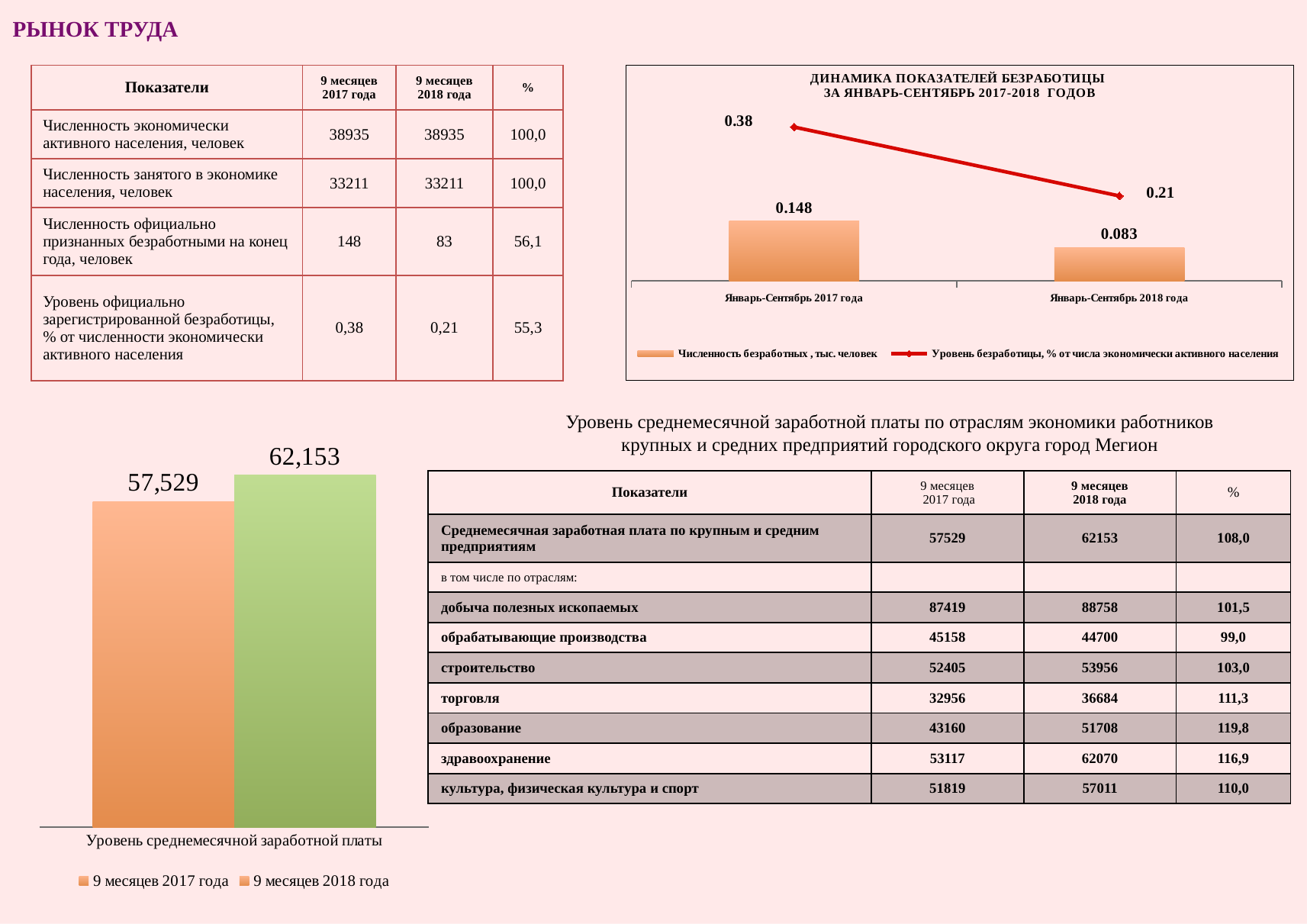
In the bottom-left chart 'Уровень среднемесячной заработной платы', what is the value for 9 месяцев 2017 года? 57,529 In the chart titled 'ДИНАМИКА ПОКАЗАТЕЛЕЙ БЕЗРАБОТИЦЫ', which period has the higher 'Численность безработных' bar? Январь-Сентябрь 2017 года In the bottom-left chart 'Уровень среднемесячной заработной платы', what is the value for 9 месяцев 2018 года? 62,153 What kind of chart is the bottom-left chart 'Уровень среднемесячной заработной платы'? bar chart In the chart titled 'ДИНАМИКА ПОКАЗАТЕЛЕЙ БЕЗРАБОТИЦЫ', what is the 'Уровень безработицы' value for Январь-Сентябрь 2018 года? 0.21 In the bottom-left chart 'Уровень среднемесячной заработной платы', what is the difference between the 2018 and 2017 values? 4,624 In the chart titled 'ДИНАМИКА ПОКАЗАТЕЛЕЙ БЕЗРАБОТИЦЫ', what is the 'Уровень безработицы' value for Январь-Сентябрь 2017 года? 0.38 In the chart titled 'ДИНАМИКА ПОКАЗАТЕЛЕЙ БЕЗРАБОТИЦЫ', does the unemployment rate line rise or fall from 2017 to 2018? fall In the chart titled 'ДИНАМИКА ПОКАЗАТЕЛЕЙ БЕЗРАБОТИЦЫ', what is the value of 'Численность безработных, тыс. человек' for Январь-Сентябрь 2018 года? 0.083 In the chart titled 'ДИНАМИКА ПОКАЗАТЕЛЕЙ БЕЗРАБОТИЦЫ', what is the value of 'Численность безработных, тыс. человек' for Январь-Сентябрь 2017 года? 0.148 In the chart titled 'ДИНАМИКА ПОКАЗАТЕЛЕЙ БЕЗРАБОТИЦЫ', what is the difference between the 'Уровень безработицы' values for 2017 and 2018? 0.17 In the chart titled 'ДИНАМИКА ПОКАЗАТЕЛЕЙ БЕЗРАБОТИЦЫ', how many series does the legend list? 2